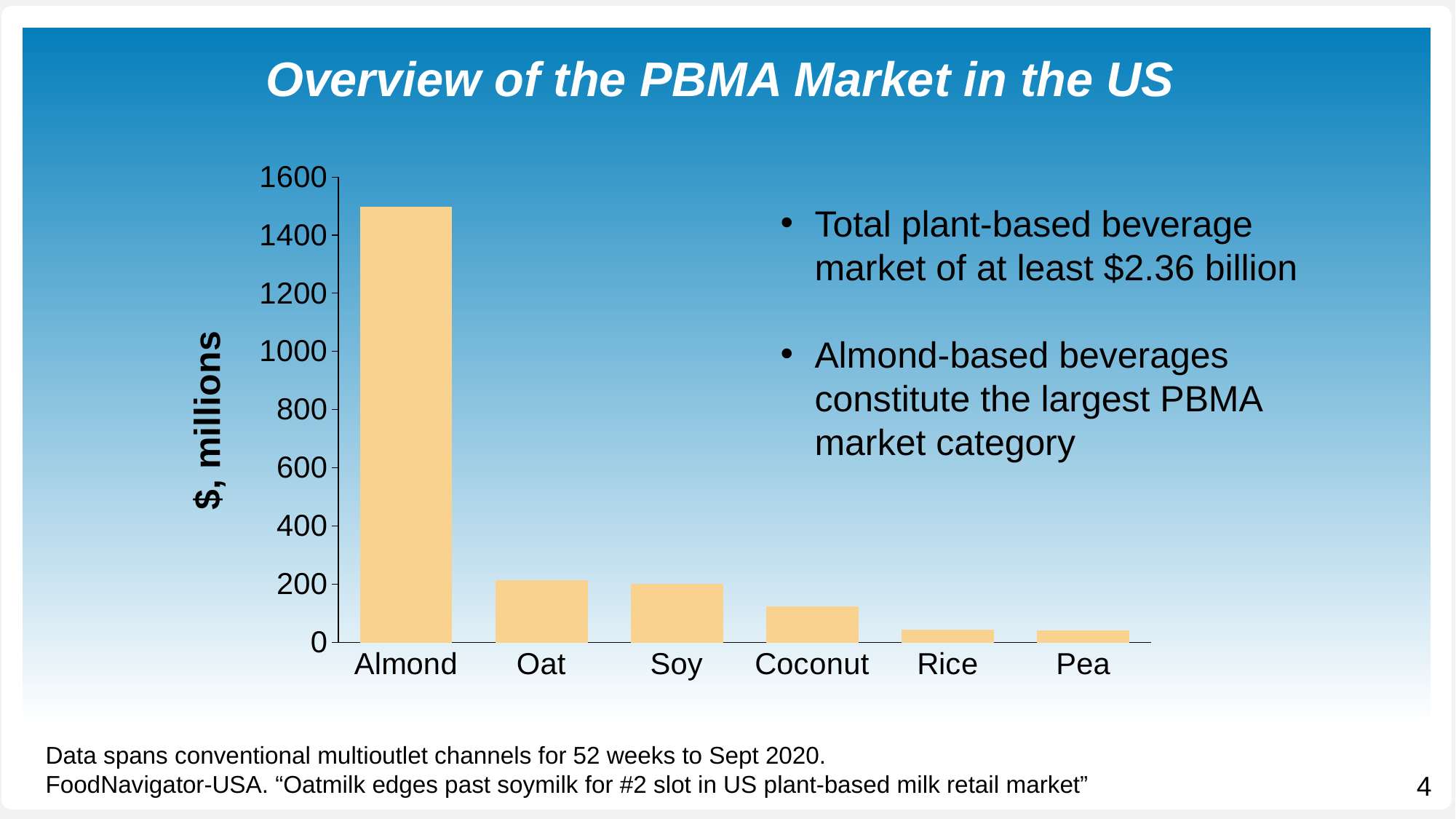
Which category has the highest value in the chart? Almond Is the value for Almond greater or less than 1400? greater What is the label on the y axis of the chart? $, millions Is the value for Coconut greater or less than 200? less Do the values generally rise or fall moving from left to right along the x axis? fall Which is larger, the value for Almond or the value for Oat? Almond Which is larger, the value for Coconut or the value for Rice? Coconut How many categories are shown on the x axis of the chart? 6 Is the value for Pea greater or less than 200? less What kind of chart is shown on the slide? bar chart